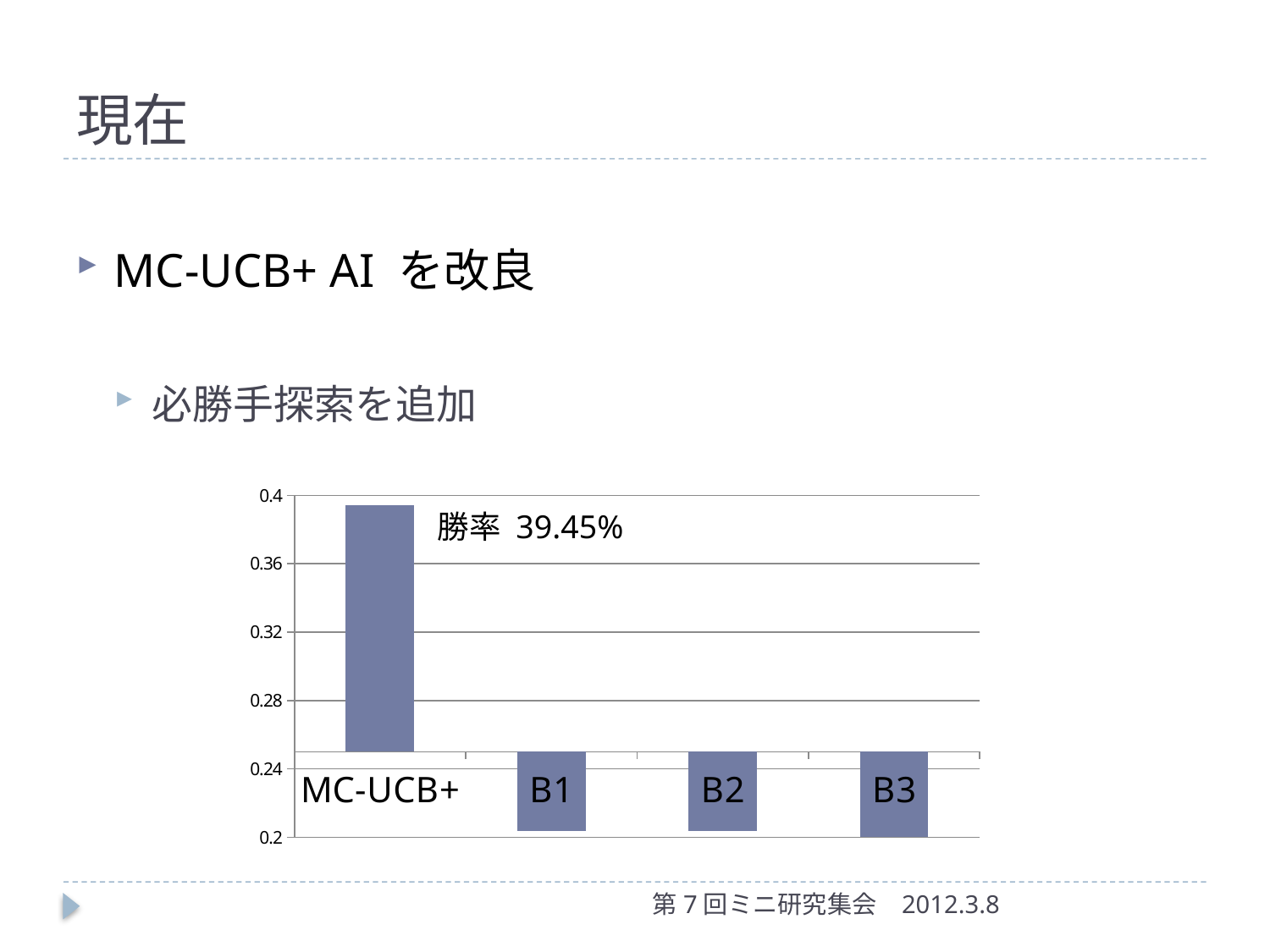
How many categories are shown on the x axis of the chart? 4 What is the highest tick value shown on the y axis of the chart? 0.4 What win rate (勝率) is printed on the chart for MC-UCB+? 39.45% What is the label of the first category on the x axis? MC-UCB+ Which category has the highest bar in the chart? MC-UCB+ Is the value for B3 greater or less than 0.32? less What is the lowest tick value shown on the y axis of the chart? 0.2 What kind of chart is shown on the slide? bar chart Is the value for B1 greater or less than 0.28? less Which is larger, the value for MC-UCB+ or the value for B2? MC-UCB+ Is the value for MC-UCB+ greater or less than 0.36? greater